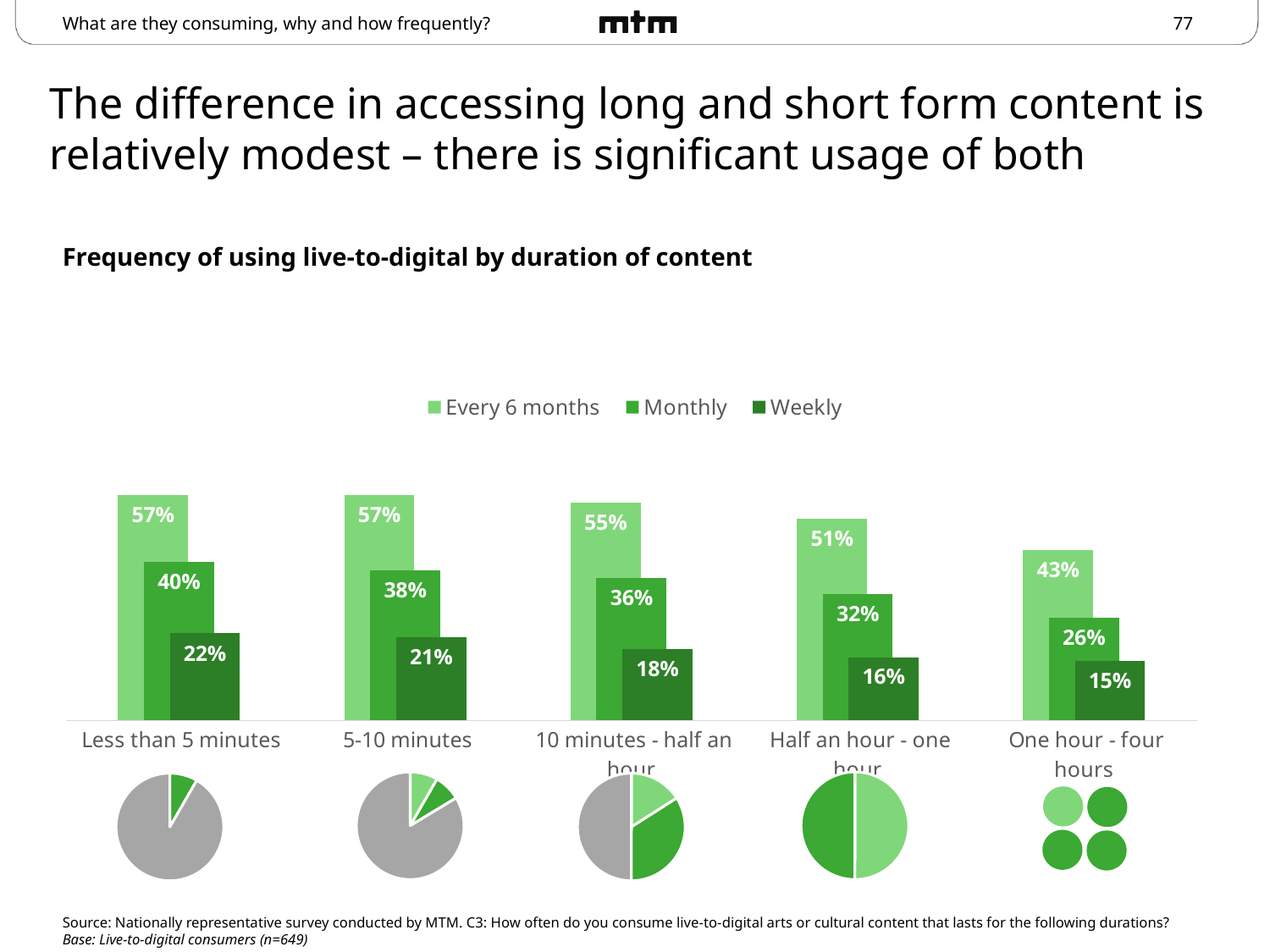
What kind of chart is used to show frequency of using live-to-digital by duration of content? Bar chart What is the Weekly value for '5-10 minutes'? 21% Which duration category has the highest Weekly value? Less than 5 minutes Which duration category has the lowest Every 6 months value? One hour - four hours How many series does the legend list? 3 What are the three series named in the legend? Every 6 months, Monthly, Weekly Which is larger: the Monthly value for 'Less than 5 minutes' or the Monthly value for 'One hour - four hours'? Less than 5 minutes What is the difference between the Every 6 months and Weekly values for 'Less than 5 minutes'? 35 percentage points Do the Weekly values rise or fall as content duration increases along the x axis? Fall How many duration categories are shown on the x axis of the chart? 5 What is the Every 6 months value for 'Half an hour - one hour'? 51% What is the Monthly value for '10 minutes - half an hour'? 36%